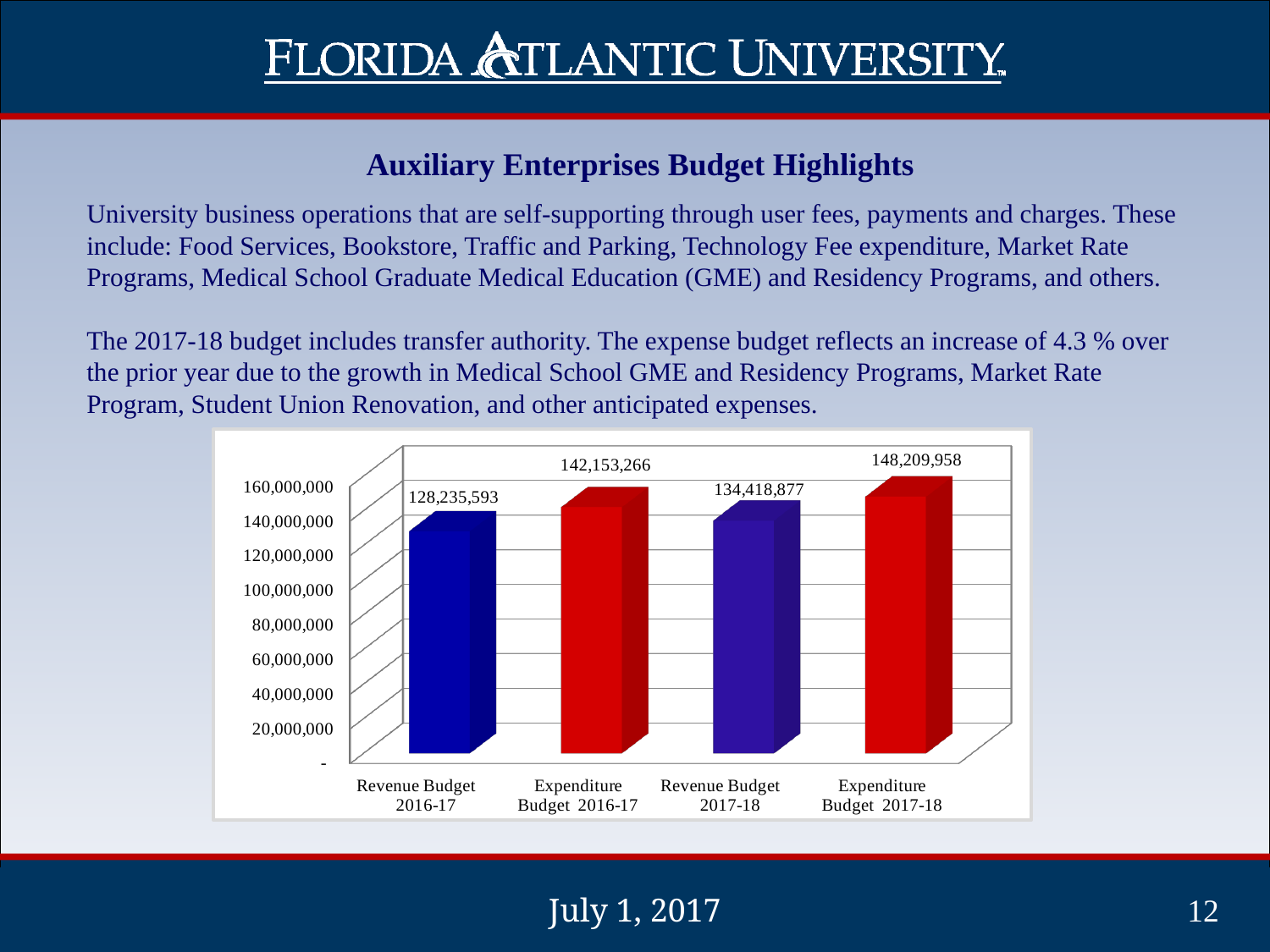
What is the difference between Revenue Budget 2017-18 and Revenue Budget 2016-17? 6,183,284 Is the value for Revenue Budget 2016-17 greater or less than 120,000,000? greater What is the value for Expenditure Budget 2016-17? 142,153,266 What kind of chart is shown on the slide? bar chart What is the difference between Expenditure Budget 2017-18 and Expenditure Budget 2016-17? 6,056,692 How many bars are shown in the chart? 4 Which category has the highest value? Expenditure Budget 2017-18 What is the value for Revenue Budget 2016-17? 128,235,593 What is the value for Revenue Budget 2017-18? 134,418,877 Which category has the lowest value? Revenue Budget 2016-17 What is the value for Expenditure Budget 2017-18? 148,209,958 Which is larger, Revenue Budget 2017-18 or Expenditure Budget 2016-17? Expenditure Budget 2016-17